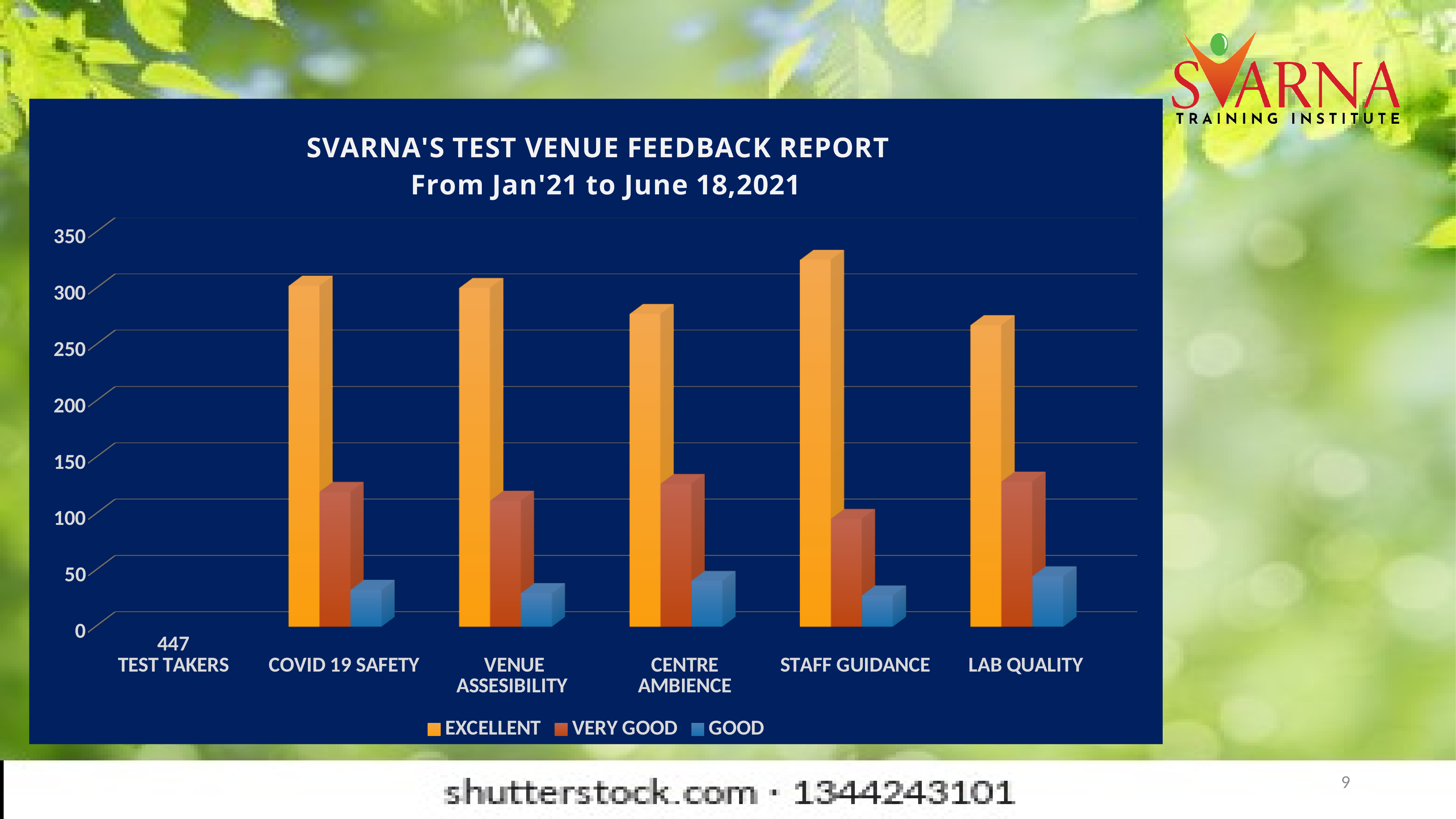
What kind of chart is shown on the slide? bar chart Is the EXCELLENT value for STAFF GUIDANCE greater or less than 300? greater How many feedback categories have bars plotted in the chart? 5 What are the three series listed in the legend? EXCELLENT, VERY GOOD, GOOD Is the GOOD value for STAFF GUIDANCE greater or less than 50? less How many series does the legend list? 3 Is the EXCELLENT value for LAB QUALITY greater or less than 300? less Which is larger for STAFF GUIDANCE, the EXCELLENT value or the VERY GOOD value? EXCELLENT What is the title of the chart? SVARNA'S TEST VENUE FEEDBACK REPORT From Jan'21 to June 18,2021 Which category has the highest EXCELLENT value? STAFF GUIDANCE Which category has the lowest VERY GOOD value? STAFF GUIDANCE